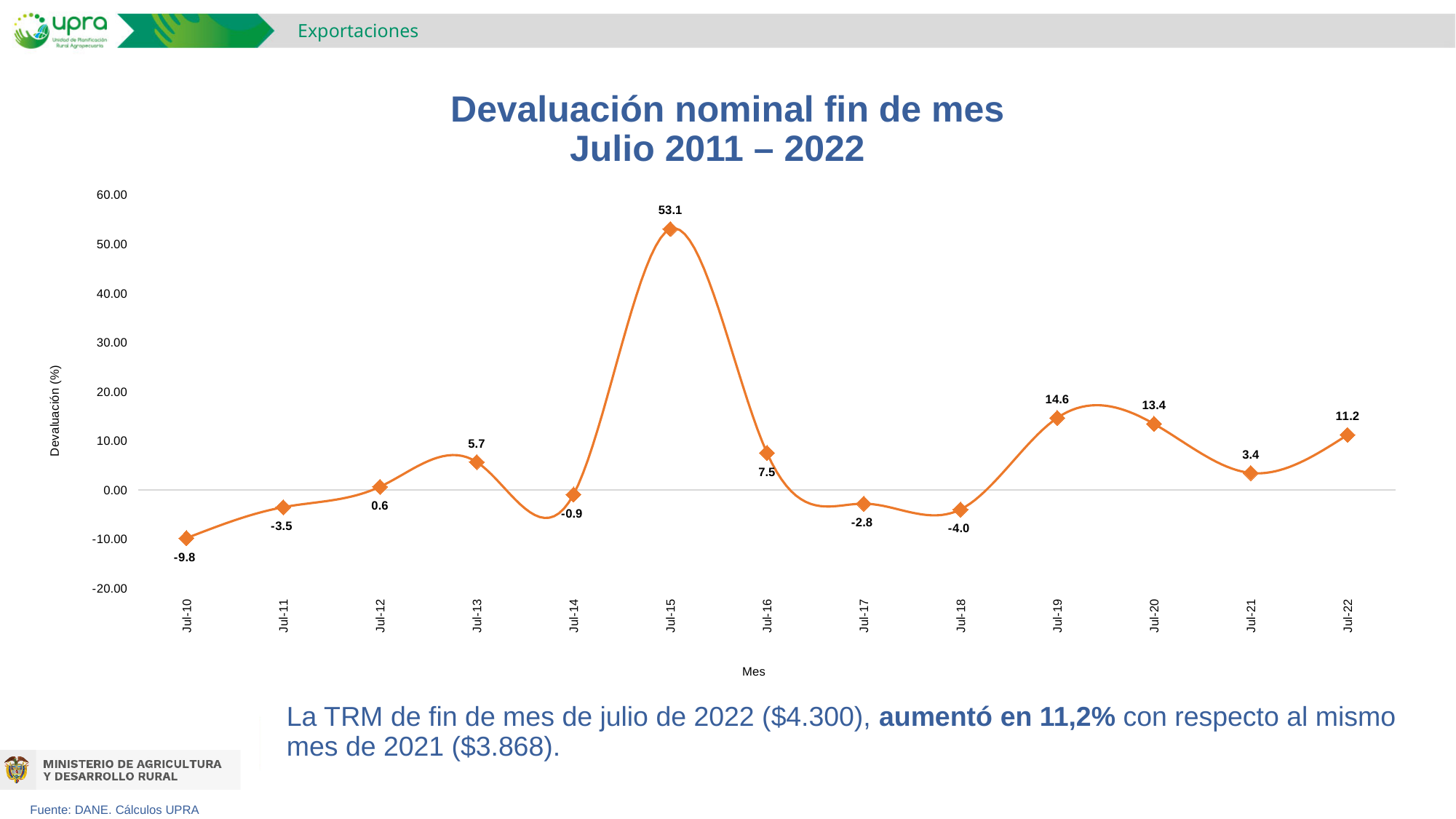
What is the devaluation value for Jul-22? 11.2 Is the value for Jul-15 greater or less than 50.00? greater How many data points are plotted on the chart? 13 What is the devaluation value for Jul-15? 53.1 Which month has the highest devaluation value? Jul-15 Which is larger, the value for Jul-16 or the value for Jul-13? Jul-16 Which month has the lowest devaluation value? Jul-10 What is the title of the chart? Devaluación nominal fin de mes Julio 2011 – 2022 Do the values rise or fall from Jul-20 to Jul-21? Fall What is the devaluation value for Jul-10? -9.8 What kind of chart is shown on the slide? Line chart What is the difference between the values for Jul-19 and Jul-20? 1.2